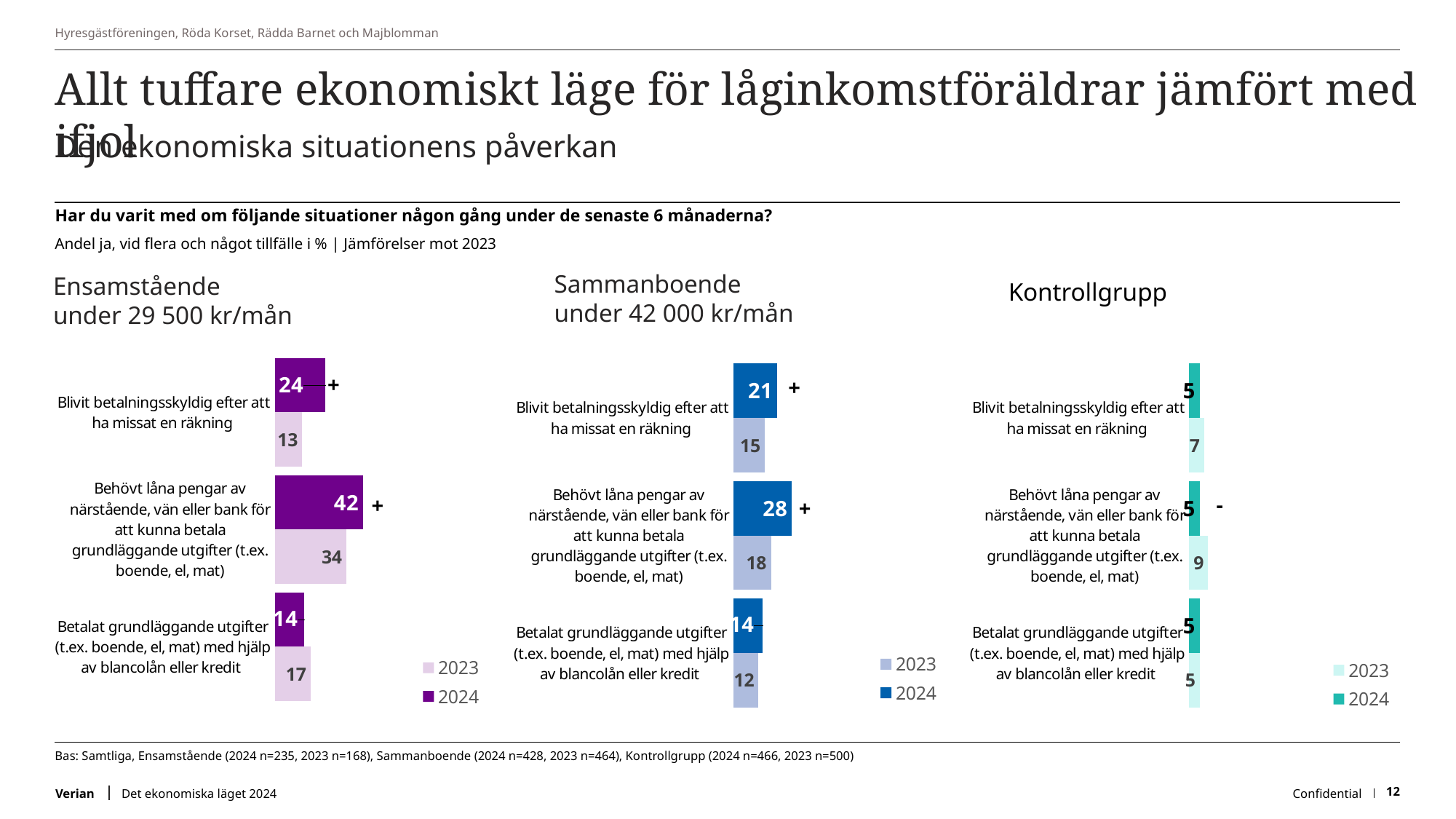
In the Ensamstående chart, for 'Betalat grundläggande utgifter med hjälp av blancolån eller kredit', which year has the larger value, 2023 or 2024? 2023 In the Sammanboende chart, what is the difference between the 2024 and 2023 values for 'Behövt låna pengar av närstående, vän eller bank'? 10 In the Ensamstående chart, what is the 2024 value for 'Behövt låna pengar av närstående, vän eller bank för att kunna betala grundläggande utgifter'? 42 In the Sammanboende chart, which category has the lowest 2023 value? Betalat grundläggande utgifter (t.ex. boende, el, mat) med hjälp av blancolån eller kredit In the Kontrollgrupp chart, what is the 2023 value for 'Behövt låna pengar av närstående, vän eller bank för att kunna betala grundläggande utgifter'? 9 In the Ensamstående chart, which category has the highest 2024 value? Behövt låna pengar av närstående, vän eller bank för att kunna betala grundläggande utgifter (t.ex. boende, el, mat) How many categories are shown in the Kontrollgrupp chart? 3 In the Sammanboende chart, what is the 2024 value for 'Blivit betalningsskyldig efter att ha missat en räkning'? 21 In the Ensamstående chart, what is the difference between the 2024 and 2023 values for 'Blivit betalningsskyldig efter att ha missat en räkning'? 11 What type of chart is the Ensamstående chart? Bar chart In the Ensamstående chart, what is the 2023 value for 'Blivit betalningsskyldig efter att ha missat en räkning'? 13 How many series does the legend of the Sammanboende chart list? 2